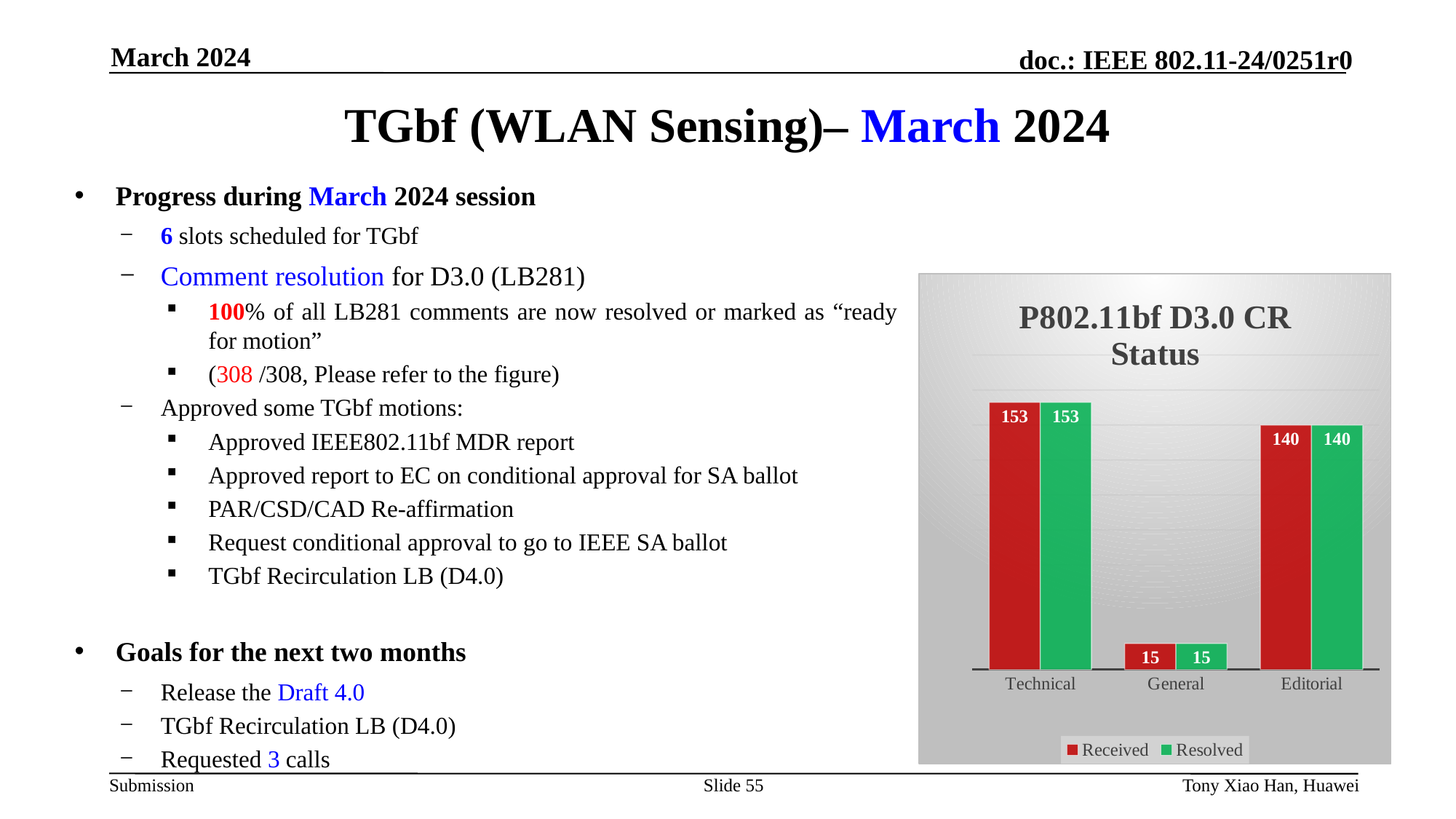
What is the Resolved value for General? 15 Which category has the lowest Resolved value? General How many categories are shown on the x axis? 3 What is the difference between the Resolved values for Editorial and General? 125 What is the Received value for Editorial? 140 What kind of chart is shown? bar chart Which category has the highest Received value? Technical Which is larger, the Received value for Technical or the Received value for General? Technical How many series does the legend list? 2 What is the title of the chart? P802.11bf D3.0 CR Status What is the Received value for Technical? 153 What is the difference between the Received values for Technical and Editorial? 13